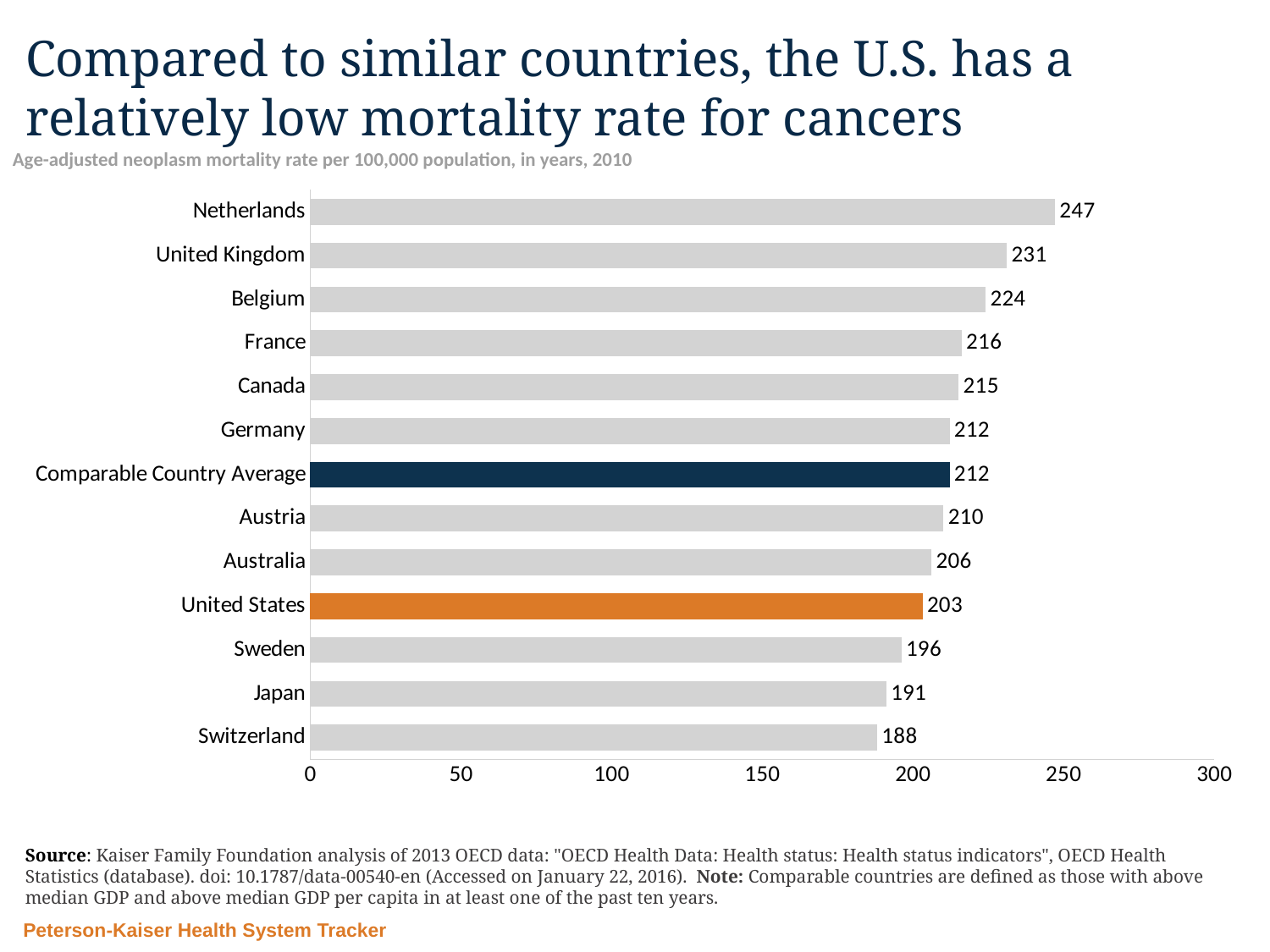
What is the age-adjusted neoplasm mortality rate for the United States? 203 Which bar is coloured orange on the chart? United States Which country has the highest neoplasm mortality rate on the chart? Netherlands What is the difference between the Netherlands' value and the United States' value? 44 How much lower is the United States' rate than the Comparable Country Average? 9 What type of chart is shown on the slide? Bar chart How many bars are shown on the chart? 13 What is the value shown for the Comparable Country Average? 212 Which country has the lowest neoplasm mortality rate on the chart? Switzerland Which has a higher mortality rate, the United Kingdom or Belgium? United Kingdom What is the mortality rate shown for Japan? 191 Is the value for Sweden greater or less than 200? less